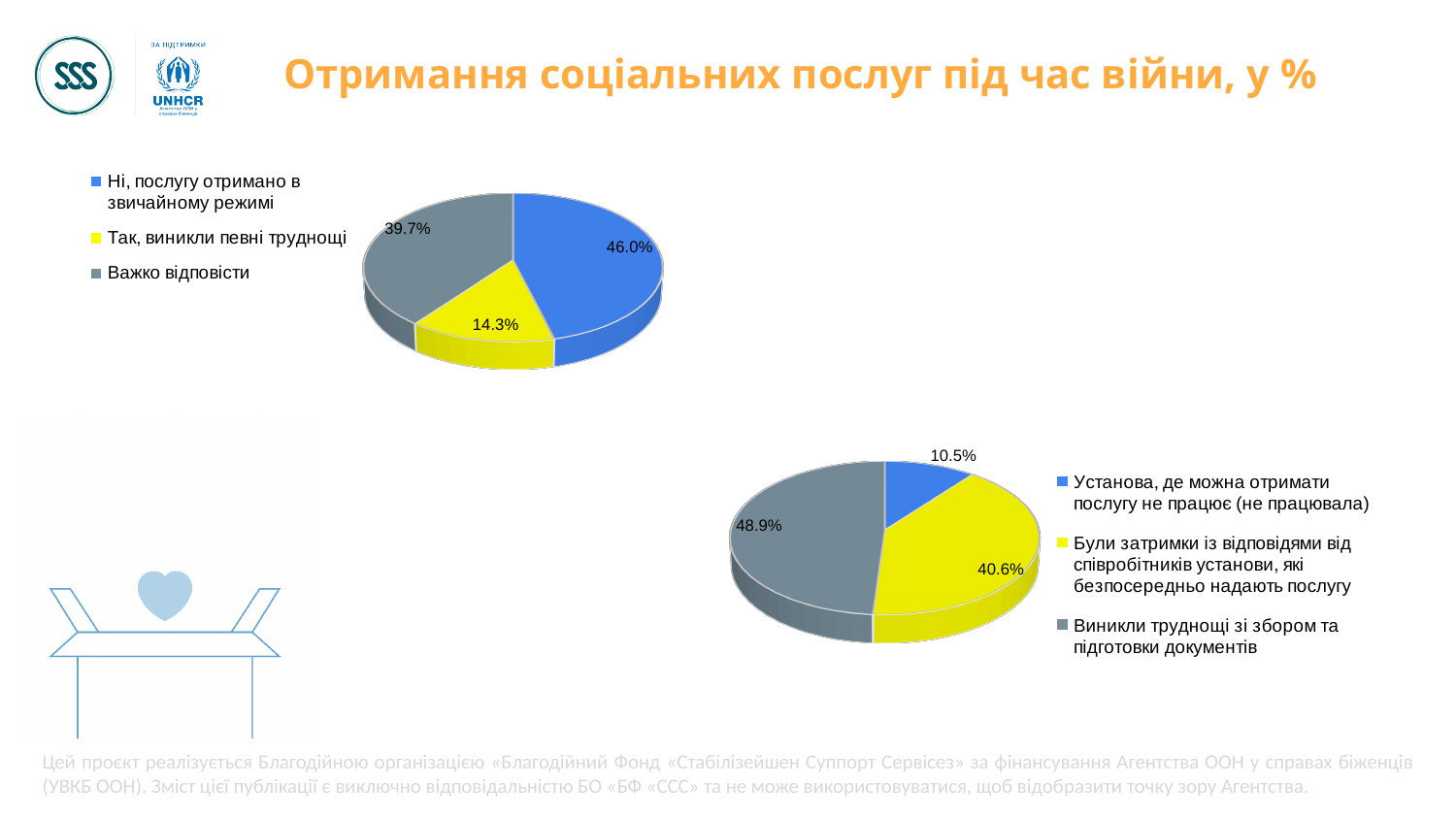
In the top-left pie chart, what share is shown for "Так, виникли певні труднощі"? 14.3% In the bottom-right pie chart, which is larger: the share for "Були затримки із відповідями від співробітників установи" or the share for "Установа, де можна отримати послугу не працює"? Були затримки із відповідями від співробітників установи In the top-left pie chart, which category has the largest share? Ні, послугу отримано в звичайному режимі In the top-left pie chart, what share is shown for "Важко відповісти"? 39.7% In the top-left pie chart, what share is shown for "Ні, послугу отримано в звичайному режимі"? 46.0% How many categories does the bottom-right pie chart show? 3 In the bottom-right pie chart, what share is shown for "Виникли труднощі зі збором та підготовки документів"? 48.9% In the bottom-right pie chart, which category has the largest share? Виникли труднощі зі збором та підготовки документів What type of chart is the top-left chart? Pie chart In the bottom-right pie chart, what share is shown for "Установа, де можна отримати послугу не працює (не працювала)"? 10.5% In the top-left pie chart, which category has the smallest share? Так, виникли певні труднощі In the top-left pie chart, what is the difference between the shares for "Ні, послугу отримано в звичайному режимі" and "Важко відповісти"? 6.3%